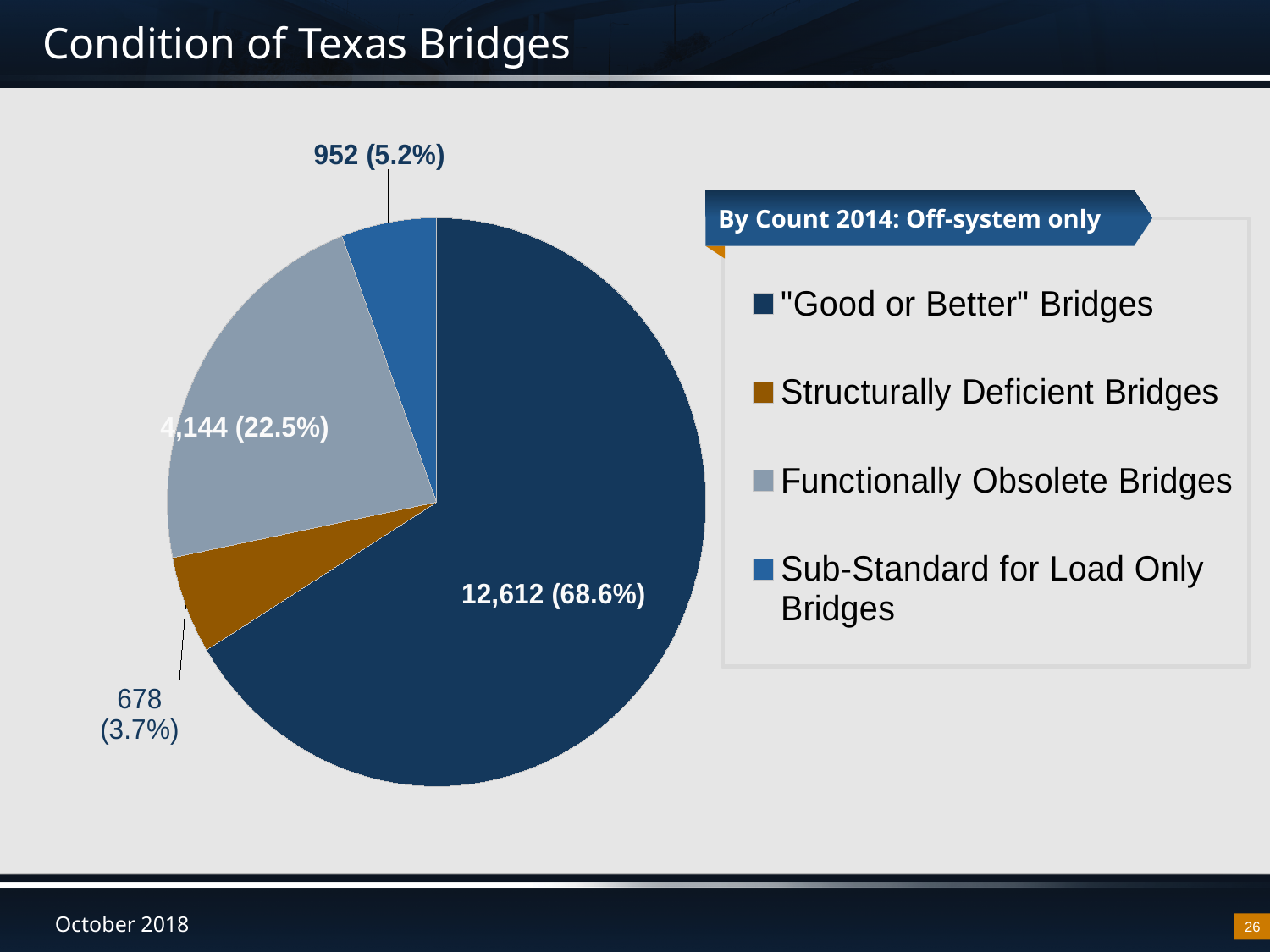
What is the percentage share of Structurally Deficient Bridges? 3.7% What is the title shown in the box above the legend? By Count 2014: Off-system only What is the difference in count between Functionally Obsolete Bridges and Sub-Standard for Load Only Bridges? 3,192 How many categories does the pie chart show? 4 What type of chart is shown on the slide? pie chart How many bridges are in the "Good or Better" Bridges category? 12,612 Which category has the smallest slice of the pie? Structurally Deficient Bridges What percentage of bridges are Functionally Obsolete Bridges? 22.5% What share of the pie is Sub-Standard for Load Only Bridges? 5.2% Which is larger, the count of Structurally Deficient Bridges or Sub-Standard for Load Only Bridges? Sub-Standard for Load Only Bridges Which category has the largest slice of the pie? "Good or Better" Bridges How many Structurally Deficient Bridges are shown? 678